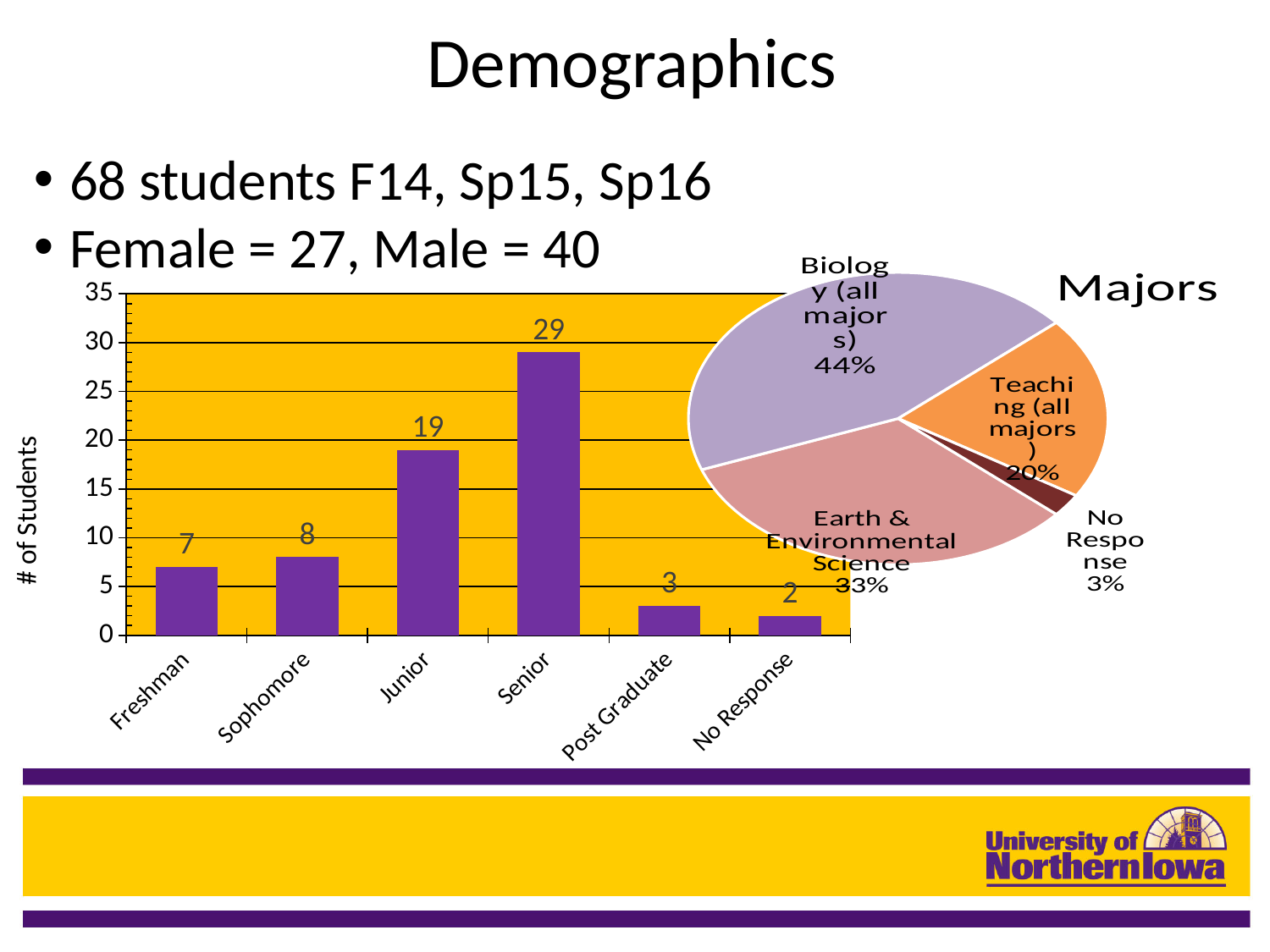
In the bar chart of # of Students, what is the difference between Senior and Junior? 10 In the Majors pie chart, which slice is the smallest? No Response In the bar chart of # of Students, what is the value for Junior? 19 What is the title of the pie chart on the right of the slide? Majors In the bar chart of # of Students, which is larger, Freshman or Sophomore? Sophomore In the bar chart of # of Students, which category has the lowest value? No Response In the bar chart of # of Students, how many categories are shown on the x axis? 6 In the bar chart of # of Students, which category has the highest value? Senior In the Majors pie chart, what share does Biology (all majors) have? 44% In the bar chart of # of Students, what is the value for Senior? 29 In the Majors pie chart, what share does Earth & Environmental Science have? 33% What kind of chart is the chart on the left of the slide? Bar chart